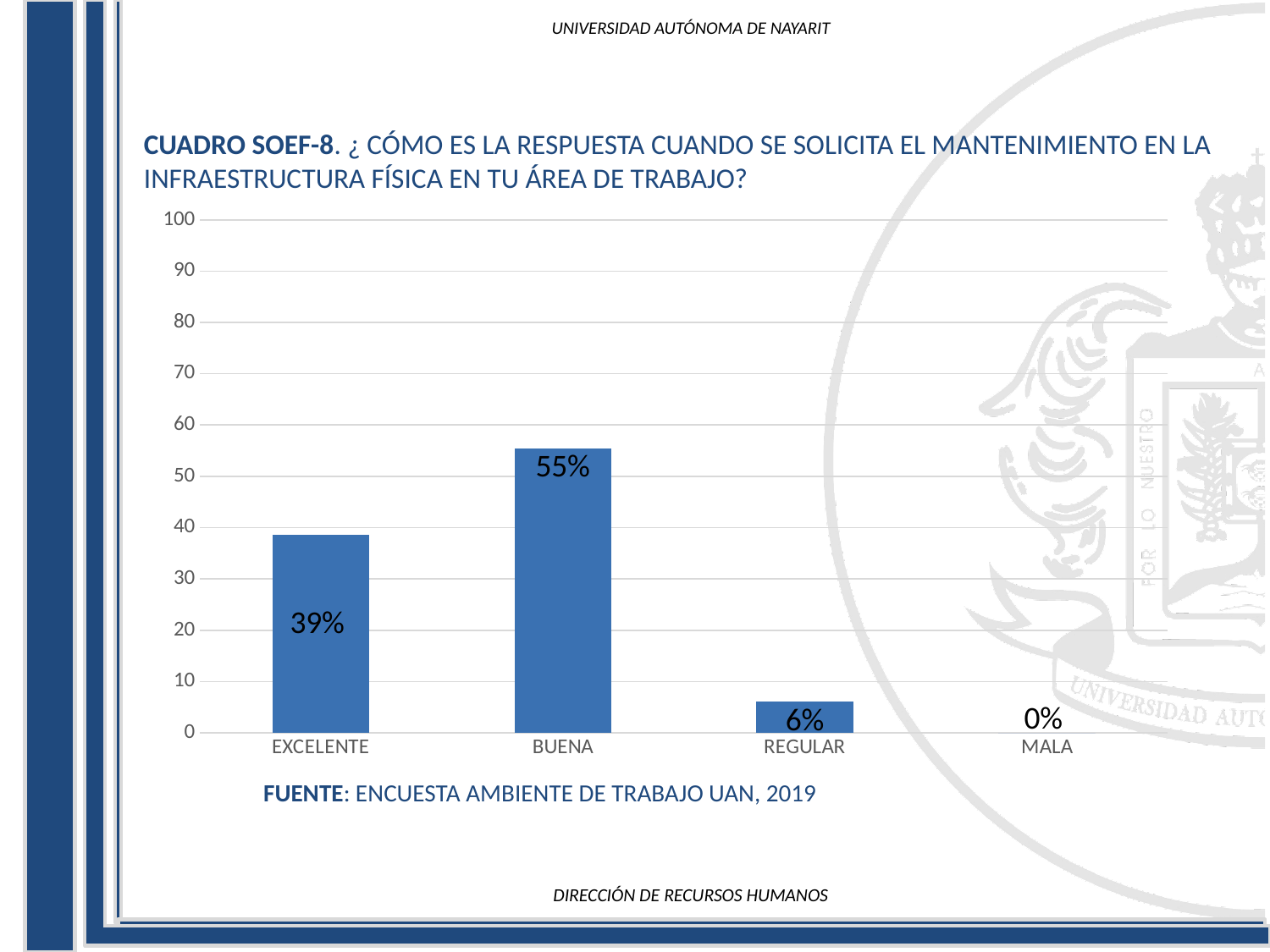
What kind of chart is shown on the slide? bar chart Which category has the highest value? BUENA What is the value for BUENA? 55% Which category has the lowest value? MALA What is the value for MALA? 0% What is the difference between the values for BUENA and EXCELENTE? 16% What source is cited below the chart? ENCUESTA AMBIENTE DE TRABAJO UAN, 2019 What is the value for EXCELENTE? 39% How many categories are shown on the x axis? 4 Is the value for EXCELENTE greater or less than 50? less What is the value for REGULAR? 6% Which is larger, the value for EXCELENTE or the value for REGULAR? EXCELENTE